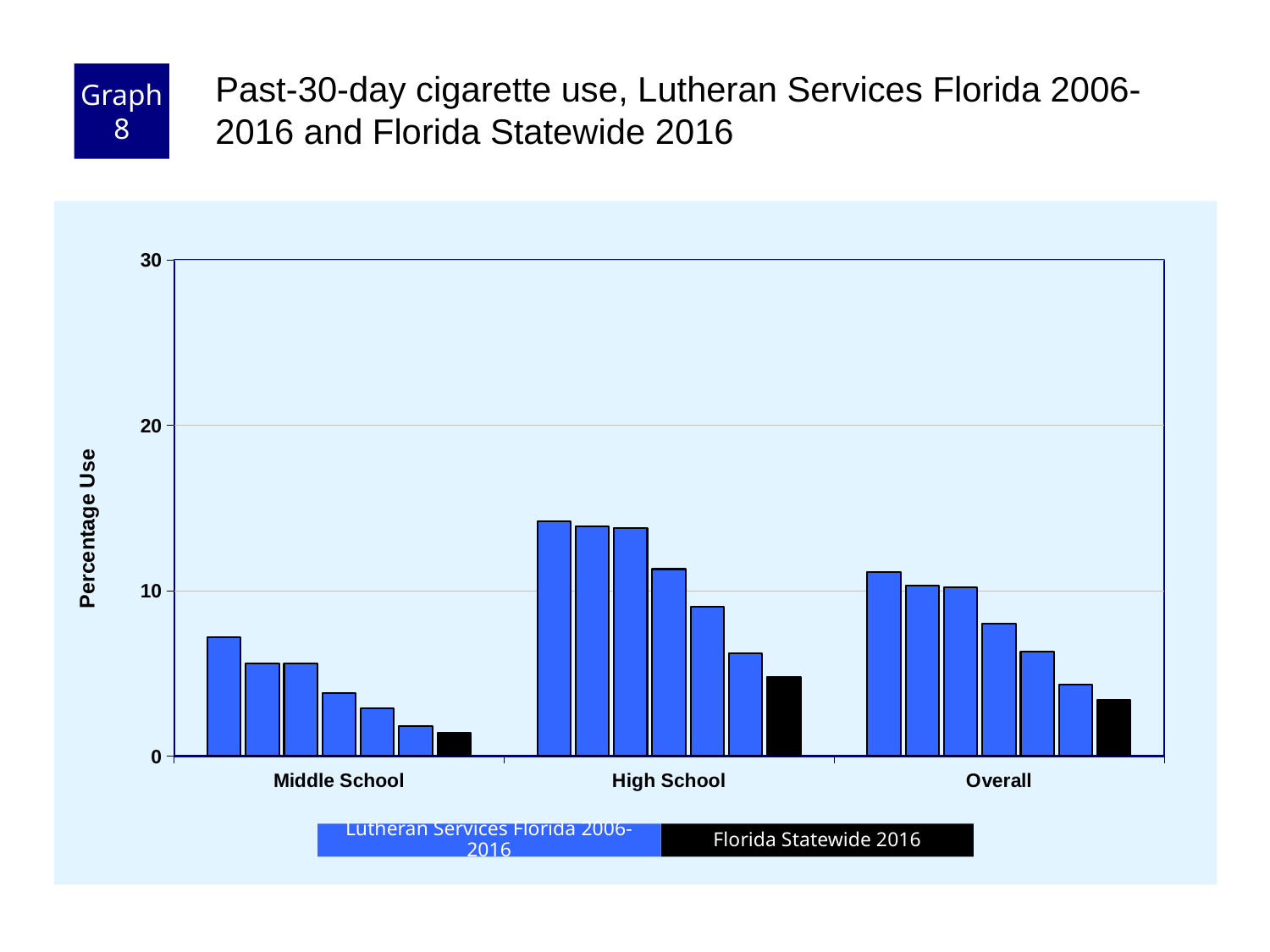
Is the tallest Lutheran Services Florida bar for High School greater or less than 20? less What is the label of the y axis? Percentage Use Is the Florida Statewide 2016 value for High School greater or less than 10? less Is the tallest Lutheran Services Florida bar for Middle School greater or less than 10? less Which series is shown in black in the legend? Florida Statewide 2016 Which category has the lowest bars overall? Middle School Which category has the highest bars overall? High School How many categories are shown on the x axis? 3 Which is larger, the Florida Statewide 2016 value for High School or for Middle School? High School What kind of chart is shown on the slide? bar chart How many series does the legend list? 2